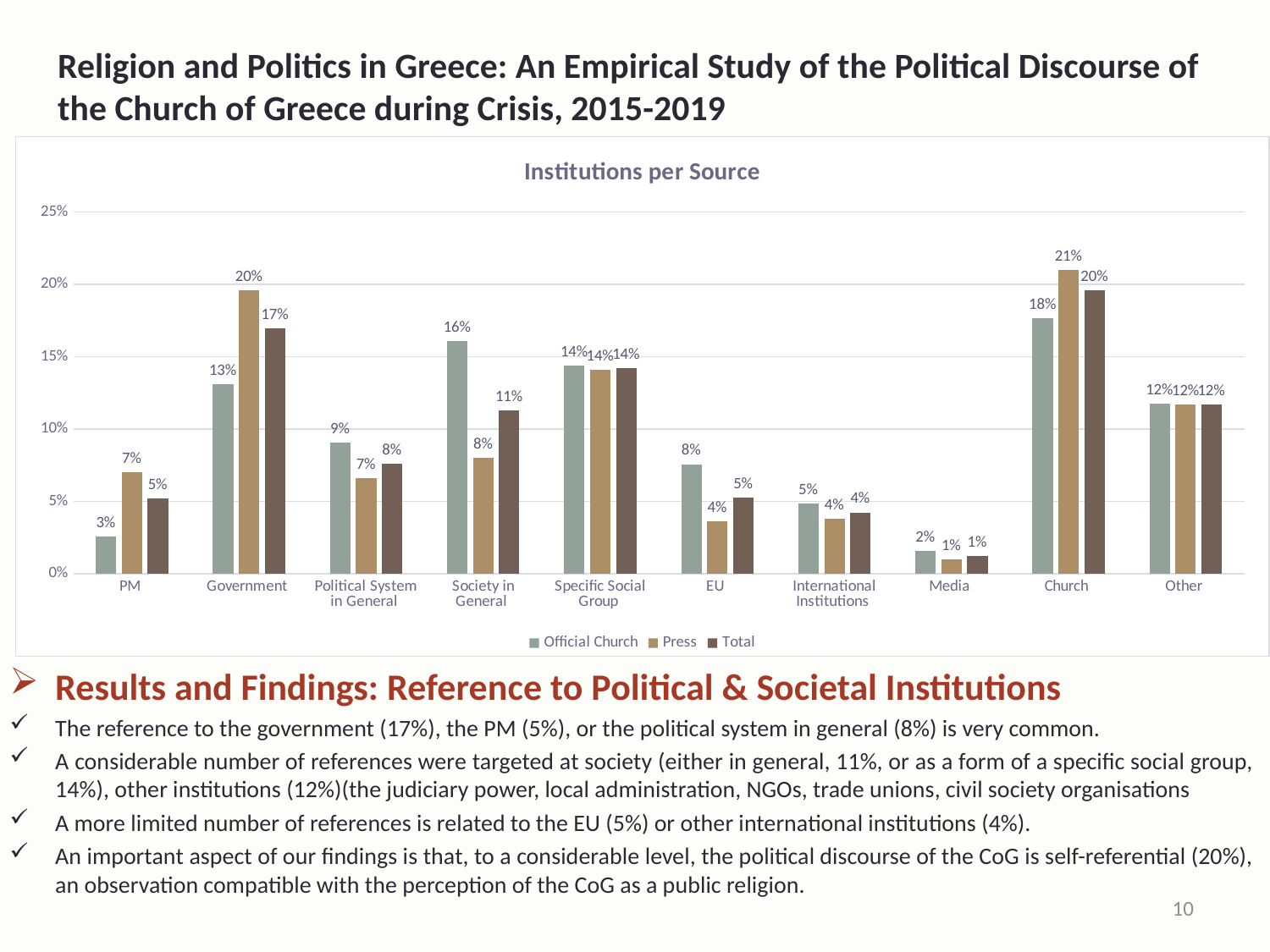
What kind of chart is shown? Bar chart Which is larger for EU: the Official Church value or the Press value? Official Church How many categories are shown on the x axis? 10 What is the difference between the Press and Official Church values for Government? 7 percentage points Is the Official Church value for Church greater or less than 15%? greater Which category has the highest Press value? Church What is the Total value for Church? 20% What is the title of the chart? Institutions per Source What is the Press value for Government? 20% Which category has the lowest Official Church value? Media What is the Official Church value for Society in General? 16% How many series does the legend list? 3